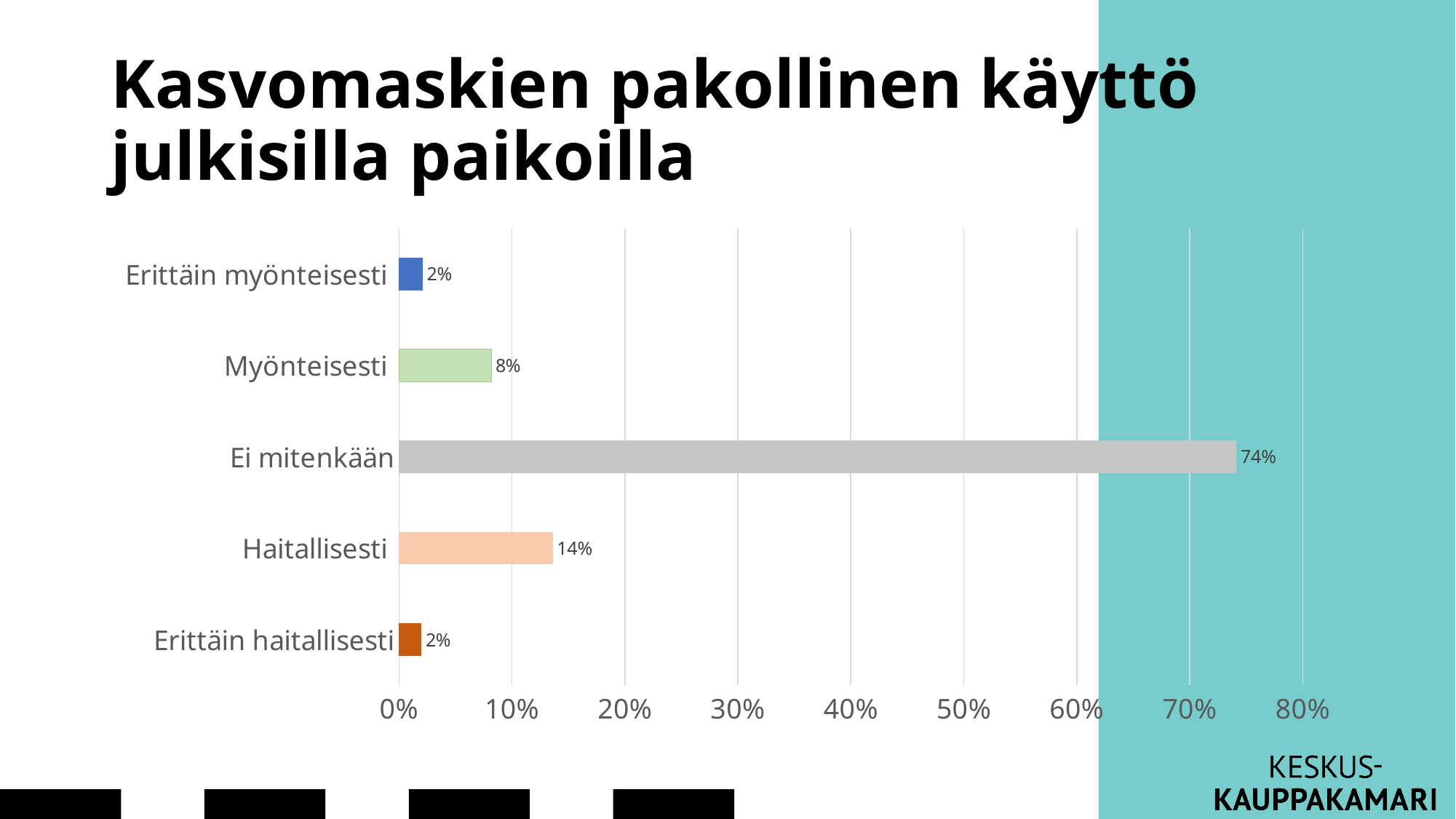
What is the title of the slide? Kasvomaskien pakollinen käyttö julkisilla paikoilla Is the value for Ei mitenkään greater or less than 70%? greater What is the value for Myönteisesti? 8% Which is larger, the value for Haitallisesti or the value for Myönteisesti? Haitallisesti How many categories are shown in the chart? 5 What is the difference between the values for Haitallisesti and Myönteisesti? 6% What is the value for Erittäin myönteisesti? 2% Which category has the highest value? Ei mitenkään What is the difference between the values for Ei mitenkään and Haitallisesti? 60% What is the value for Ei mitenkään? 74% What kind of chart is shown on the slide? bar chart What is the value for Haitallisesti? 14%